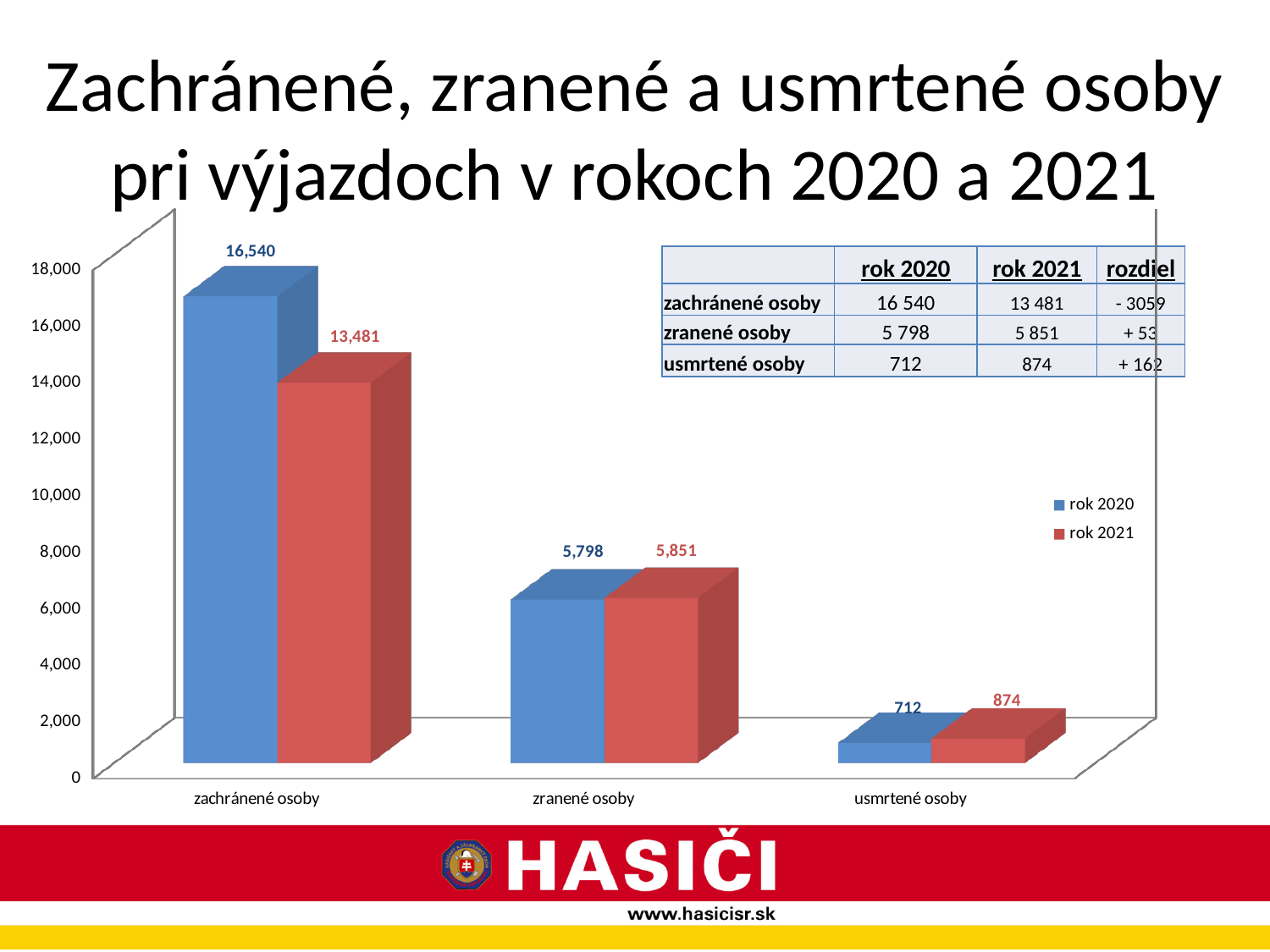
Which category has the lowest value in the rok 2021 series? usmrtené osoby What is the value for zranené osoby in the rok 2020 series? 5,798 What is the value for usmrtené osoby in the rok 2021 series? 874 What is the difference between the rok 2021 and rok 2020 values for usmrtené osoby? 162 How many series does the chart legend list? 2 What kind of chart is shown on the slide? bar chart Which category has the highest value in the rok 2020 series? zachránené osoby What is the value for zachránené osoby in the rok 2020 series? 16,540 How many categories are shown on the x axis of the chart? 3 Which is larger for zachránené osoby: the rok 2020 value or the rok 2021 value? rok 2020 What is the difference between the rok 2020 and rok 2021 values for zachránené osoby? 3,059 What is the value for zachránené osoby in the rok 2021 series? 13,481